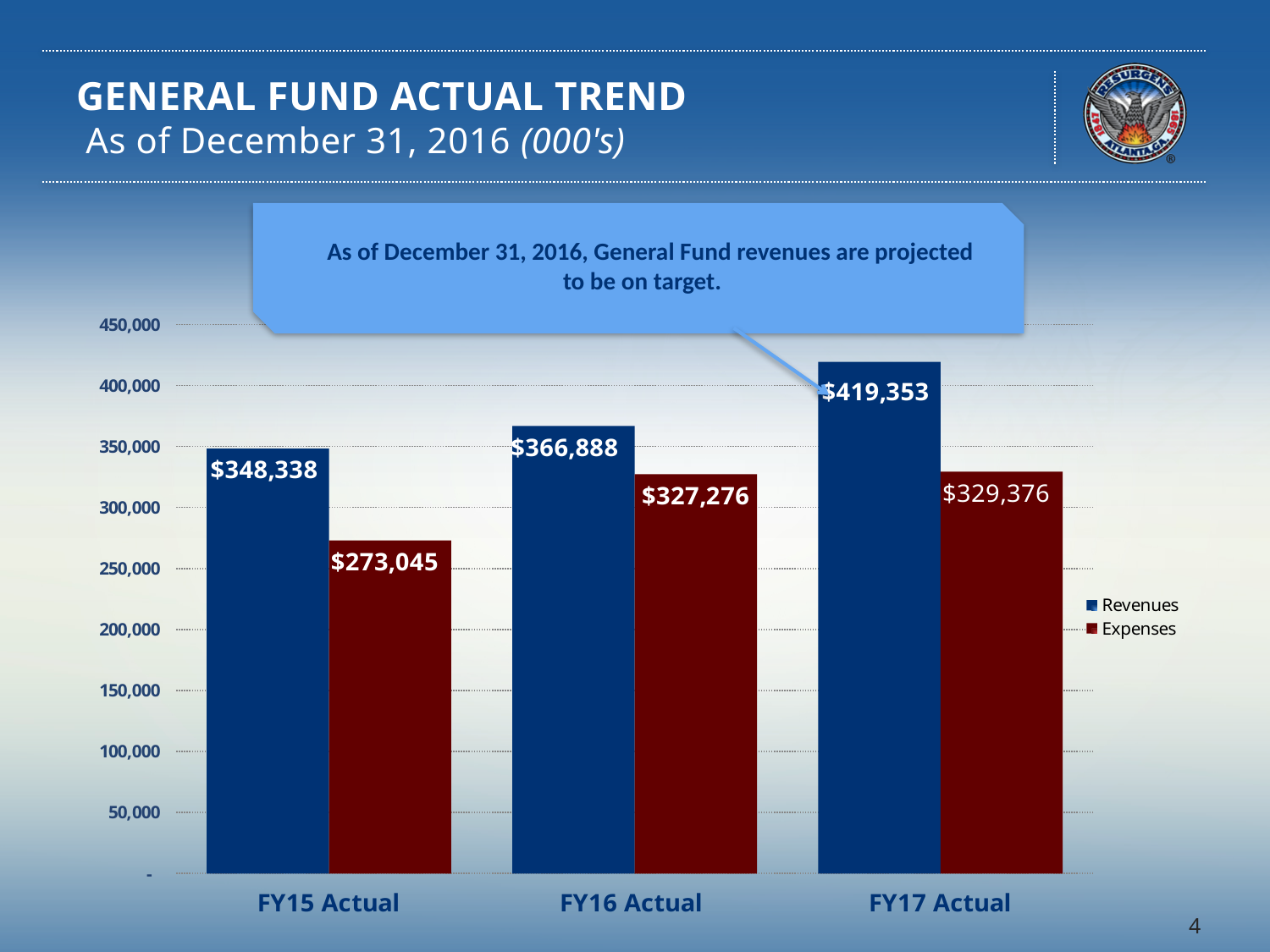
What is the difference between Revenues and Expenses for FY17 Actual? $89,977 How many series does the legend list? 2 Which fiscal year has the highest Revenues? FY17 Actual What is the Expenses value for FY16 Actual? $327,276 What is the Revenues value for FY15 Actual? $348,338 Which is larger: Revenues for FY16 Actual or Revenues for FY15 Actual? Revenues for FY16 Actual What is the difference between Revenues and Expenses for FY15 Actual? $75,293 How many fiscal year categories are shown on the x axis? 3 Is the Revenues value for FY17 Actual greater or less than 400,000? greater Which fiscal year has the lowest Expenses? FY15 Actual What is the Expenses value for FY17 Actual? $329,376 Do Revenues rise or fall from FY15 Actual to FY17 Actual? rise